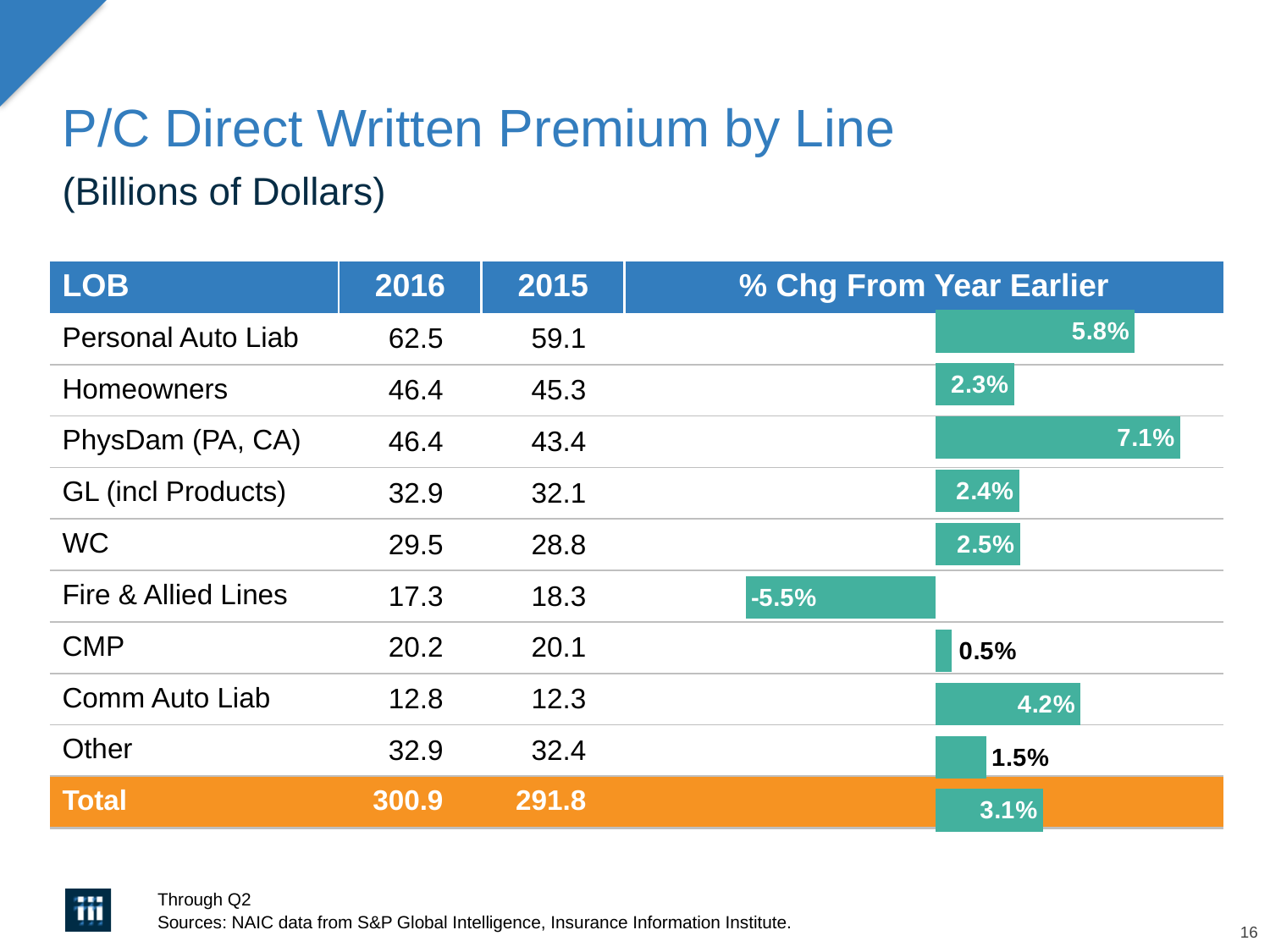
What is the % change from year earlier for Personal Auto Liab? 5.8% How many lines of business, including Total, have a % change bar in the chart? 10 What is the % change from year earlier for Fire & Allied Lines? -5.5% How many lines of business show a negative % change from year earlier? 1 What is the % change from year earlier for the Total row? 3.1% What is the % change from year earlier for Comm Auto Liab? 4.2% Which line of business has the highest % change from year earlier? PhysDam (PA, CA) Which has a larger % change from year earlier, CMP or Other? Other Which line of business has the lowest % change from year earlier? Fire & Allied Lines What is the difference in percentage points between the % change for PhysDam (PA, CA) and Personal Auto Liab? 1.3 Which has a larger % change from year earlier, Homeowners or WC? WC What kind of chart shows the % change from year earlier? bar chart